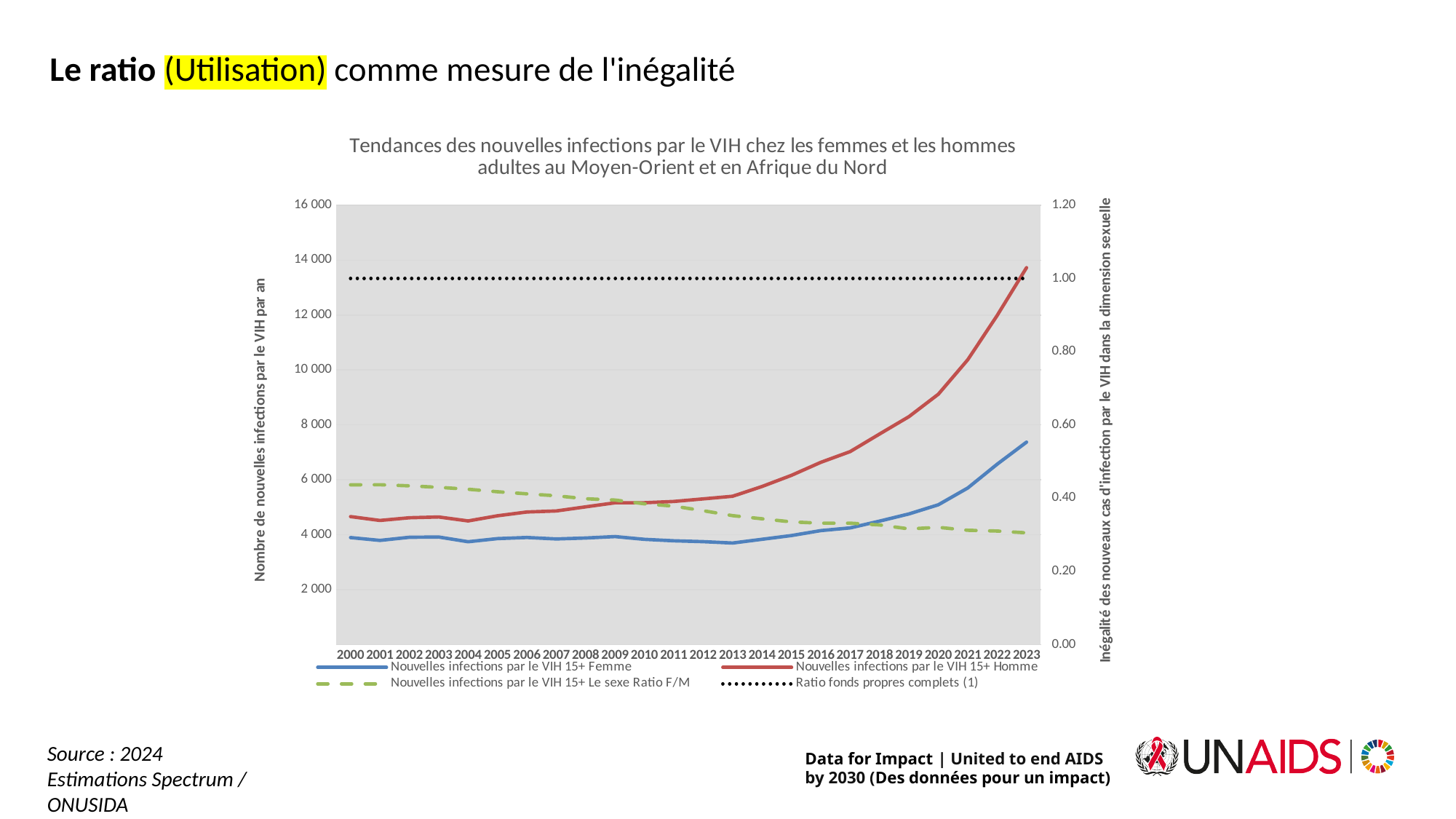
What is the first year shown on the x axis? 2000 Is the value for 'Nouvelles infections par le VIH 15+ Femme' in 2023 greater or less than 6 000? greater What kind of chart is shown on the slide? line chart Does the 'Nouvelles infections par le VIH 15+ Homme' series rise or fall from 2013 to 2023? rise Is the 'Nouvelles infections par le VIH 15+ Le sexe Ratio F/M' value in 2023 greater or less than 0.40 on the right axis? less Is the value for 'Nouvelles infections par le VIH 15+ Femme' in 2000 greater or less than 6 000? less In 2023, which series is larger: 'Nouvelles infections par le VIH 15+ Homme' or 'Nouvelles infections par le VIH 15+ Femme'? Nouvelles infections par le VIH 15+ Homme Does the 'Nouvelles infections par le VIH 15+ Le sexe Ratio F/M' series rise or fall from 2000 to 2023? fall How many years are shown along the x axis of the chart? 24 How many series does the chart legend list? 4 In which year does the 'Nouvelles infections par le VIH 15+ Homme' series reach its highest value? 2023